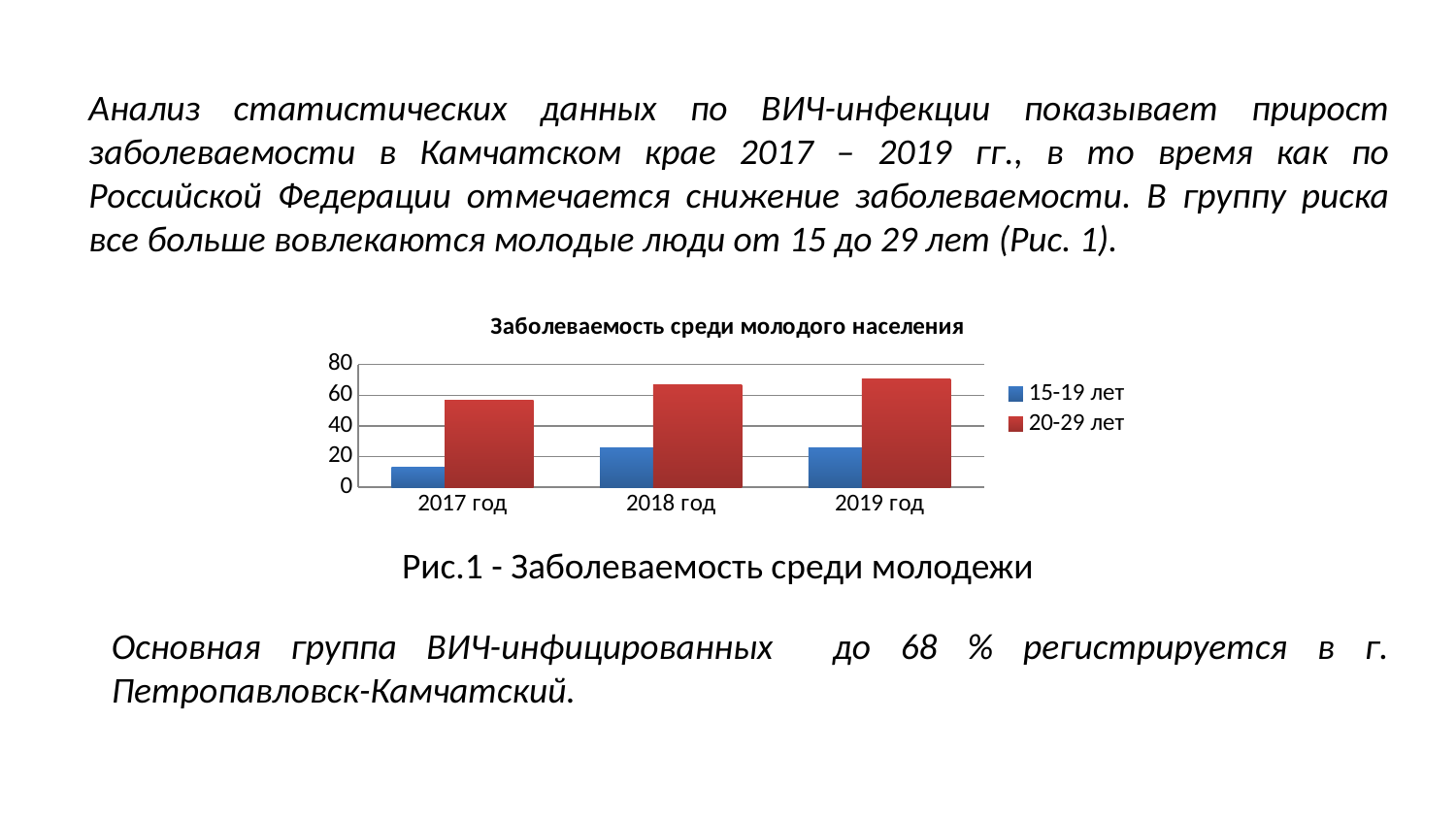
Is the value for 20-29 лет in 2019 год greater or less than 60? greater What is the title of the chart? Заболеваемость среди молодого населения In which year is the value for 15-19 лет the lowest? 2017 год How many year categories are shown on the x axis of the chart? 3 Is the value for 15-19 лет in 2017 год greater or less than 20? less What kind of chart is shown on the slide? bar chart How many series does the chart legend list? 2 Is the value for 20-29 лет in 2017 год greater or less than 40? greater Do the values for 20-29 лет rise or fall from 2017 год to 2019 год? rise In which year is the value for 20-29 лет the lowest? 2017 год Which colour represents the 20-29 лет series in the chart? red